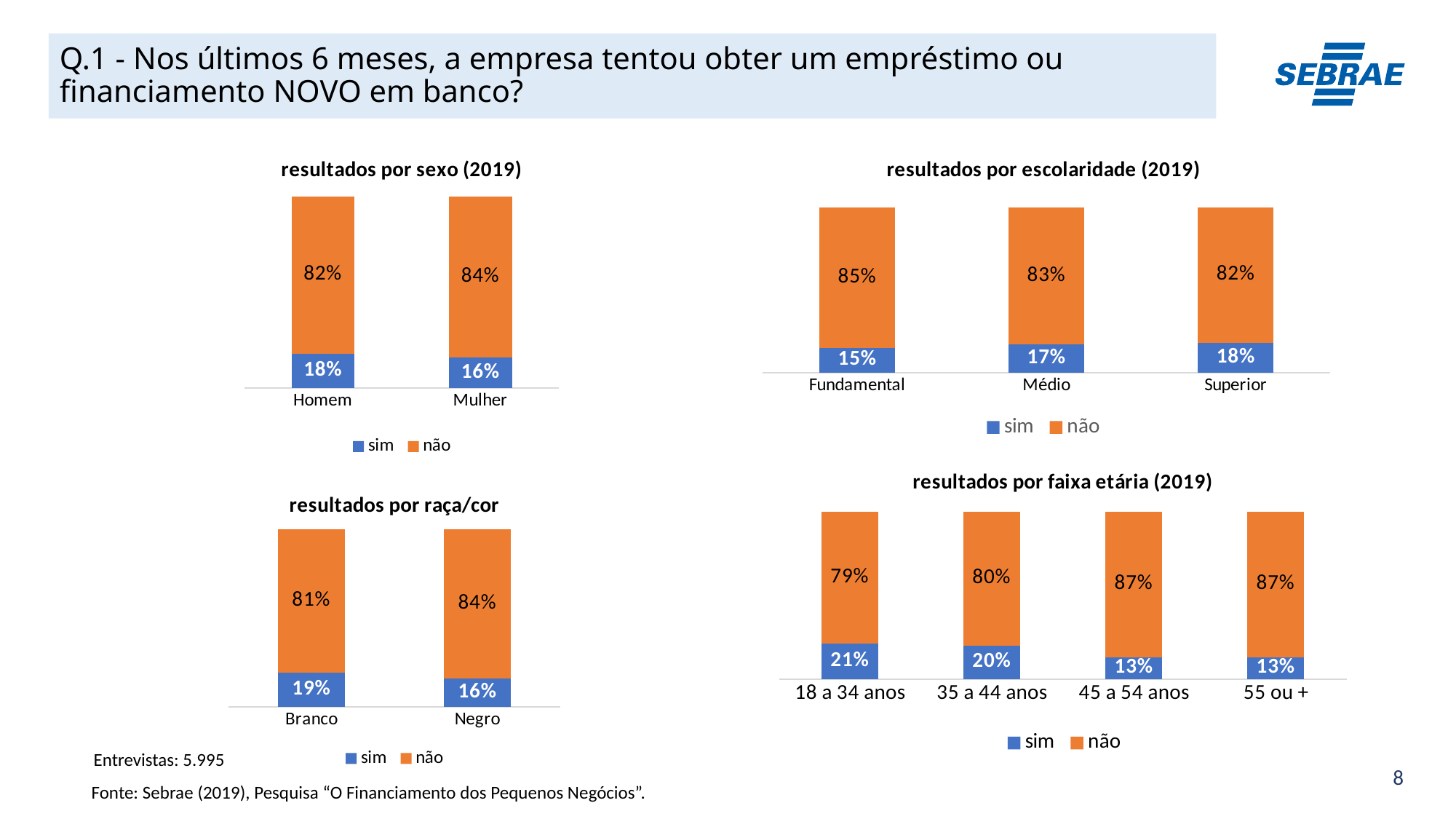
In the chart 'resultados por escolaridade (2019)', what is the 'não' value for Fundamental? 85% In the chart 'resultados por faixa etária (2019)', which age group has the highest 'sim' value? 18 a 34 anos In the chart 'resultados por sexo (2019)', what is the 'sim' value for Homem? 18% How many series does the legend list in the chart 'resultados por escolaridade (2019)'? 2 In the chart 'resultados por escolaridade (2019)', which category has the highest 'sim' value? Superior How many categories are shown in the chart 'resultados por faixa etária (2019)'? 4 In the chart 'resultados por raça/cor', what is the difference between the 'sim' values for Branco and Negro? 3% In the chart 'resultados por raça/cor', which category has the larger 'não' value, Branco or Negro? Negro In the chart 'resultados por faixa etária (2019)', what is the 'não' value for 45 a 54 anos? 87% In the chart 'resultados por sexo (2019)', what is the 'não' value for Mulher? 84% What type of chart is 'resultados por sexo (2019)'? Stacked bar chart In the chart 'resultados por faixa etária (2019)', does the 'sim' value rise or fall from 18 a 34 anos to 55 ou +? Fall